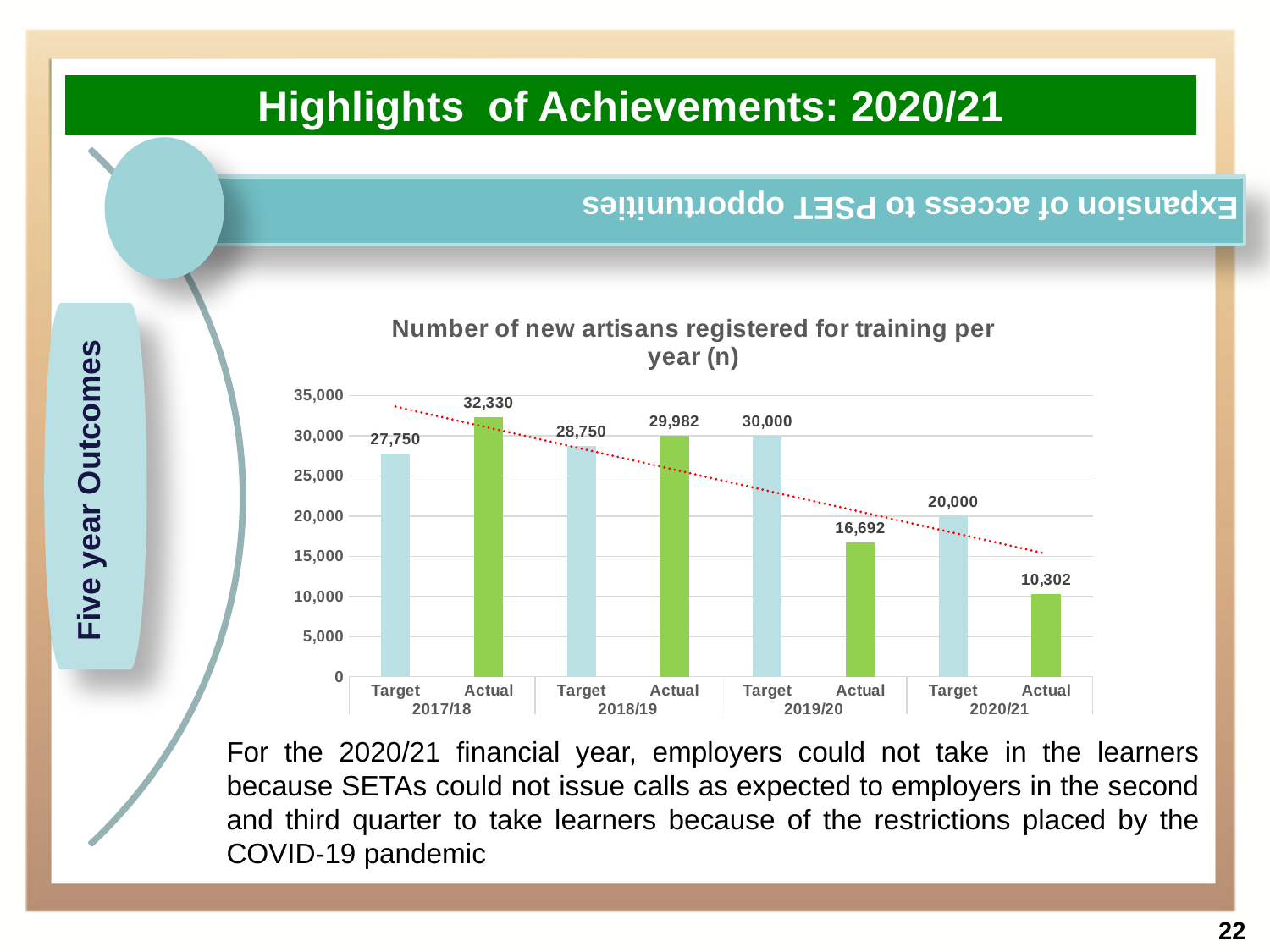
What type of chart is shown on the slide? Bar chart Is the Actual value for 2018/19 greater or less than 25,000? greater Do the Actual values rise or fall from 2017/18 to 2020/21? Fall What is the difference between the Target and Actual values for 2020/21? 9,698 Which bar has the highest value on the chart? Actual 2017/18 How many years are shown on the x axis of the chart? 4 What is the Target number of new artisans registered for training in 2020/21? 20,000 What is the difference between the Target and Actual values for 2018/19? 1,232 What is the Actual value for 2019/20? 16,692 Which bar has the lowest value on the chart? Actual 2020/21 Which is larger, the Target or the Actual value for 2019/20? Target What is the Actual number of new artisans registered for training in 2017/18? 32,330